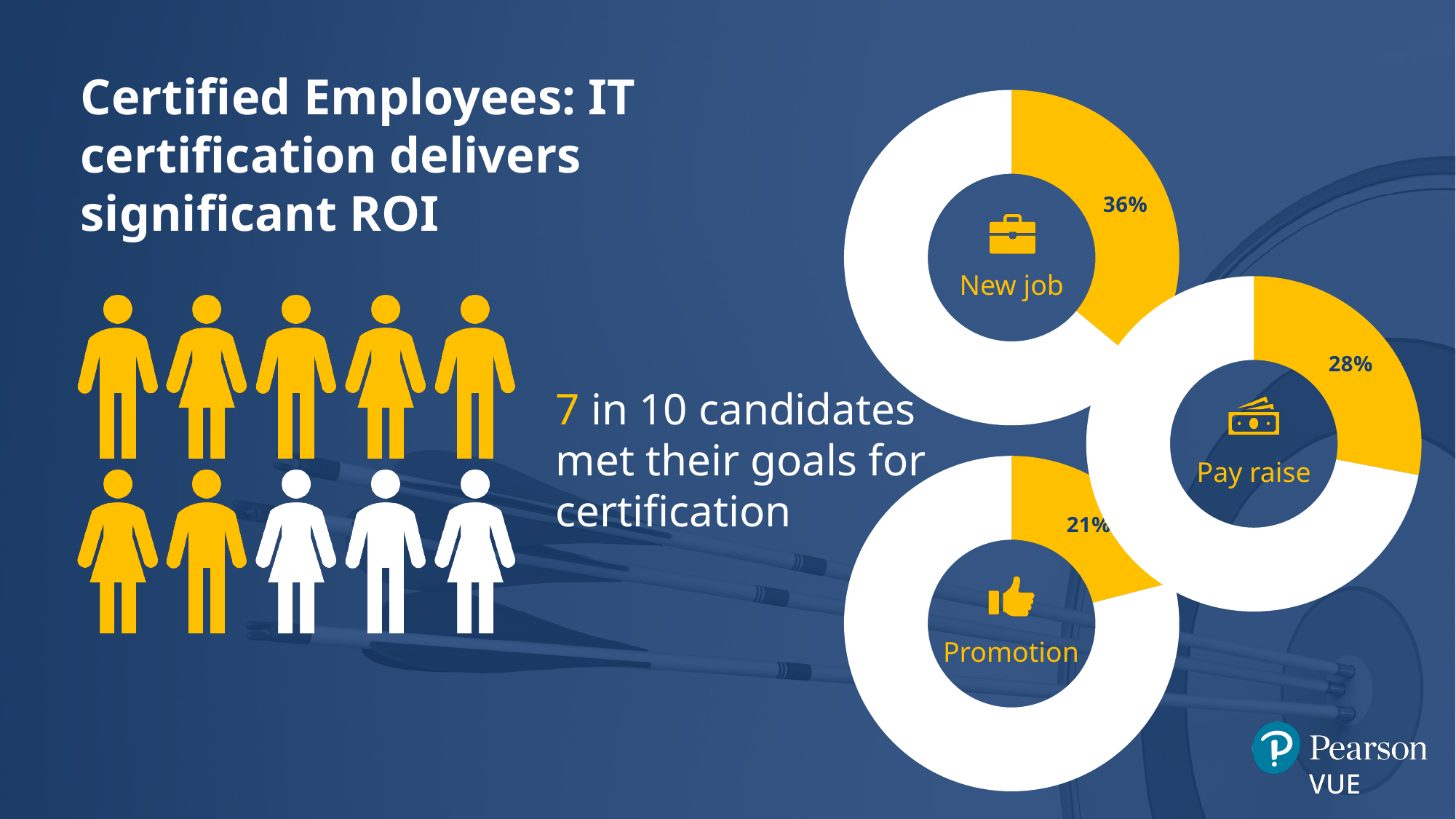
How many donut charts are shown on the right side of the slide? 3 What is the difference between the percentage in the 'Pay raise' donut chart and the percentage in the 'Promotion' donut chart? 7% What is the difference between the percentage in the 'New job' donut chart and the percentage in the 'Pay raise' donut chart? 8% Across the three donut charts (New job, Pay raise, Promotion), which goal has the lowest percentage? Promotion In the 'New job' donut chart, what percentage is shown? 36% In the pictogram of people on the left of the slide, how many of the 10 figures are coloured yellow? 7 What colour is used for the filled segment in each of the three donut charts? Yellow Across the three donut charts (New job, Pay raise, Promotion), which goal has the highest percentage? New job In the 'Promotion' donut chart, what percentage is shown? 21% Which is larger: the percentage in the 'Pay raise' donut chart or the percentage in the 'Promotion' donut chart? Pay raise In the 'Pay raise' donut chart, what percentage is shown? 28% What kind of chart is used to show the 'New job', 'Pay raise' and 'Promotion' percentages? Donut chart